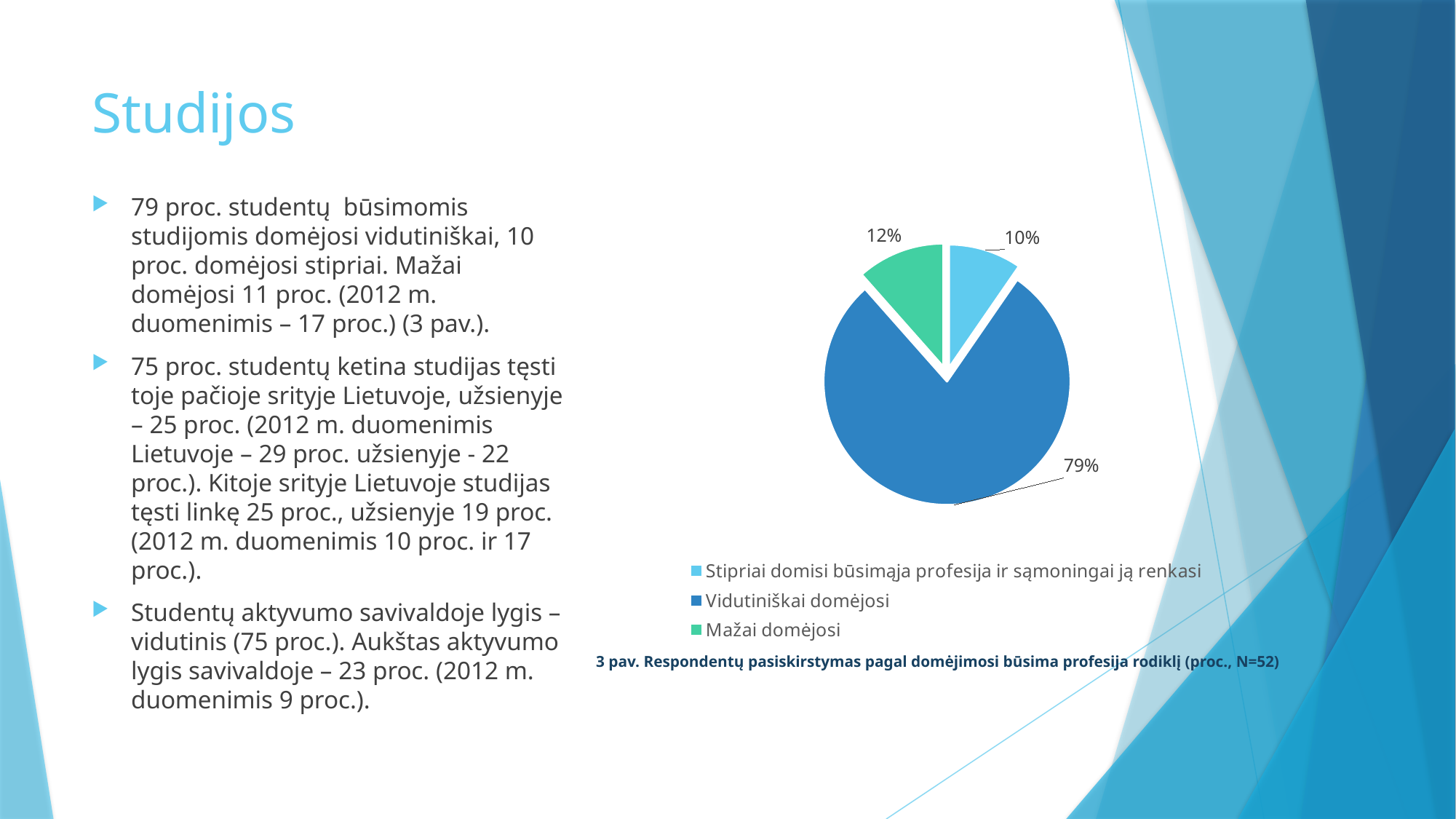
How many entries does the chart legend list? 3 What is the sample size (N) stated in the chart caption? N=52 Which category has the smallest slice of the pie? Stipriai domisi būsimąja profesija ir sąmoningai ją renkasi Which slice is larger: "Mažai domėjosi" or "Stipriai domisi būsimąja profesija ir sąmoningai ją renkasi"? Mažai domėjosi How many slices does the pie chart have? 3 What is the difference in percentage points between the "Vidutiniškai domėjosi" slice and the "Mažai domėjosi" slice? 67 What kind of chart is shown on the slide? Pie chart Which category has the largest slice of the pie? Vidutiniškai domėjosi What percentage of the pie is labelled for "Vidutiniškai domėjosi"? 79% What percentage of the pie is labelled for "Stipriai domisi būsimąja profesija ir sąmoningai ją renkasi"? 10% What percentage of the pie is labelled for "Mažai domėjosi"? 12% What colour is the "Mažai domėjosi" slice in the pie chart? Green